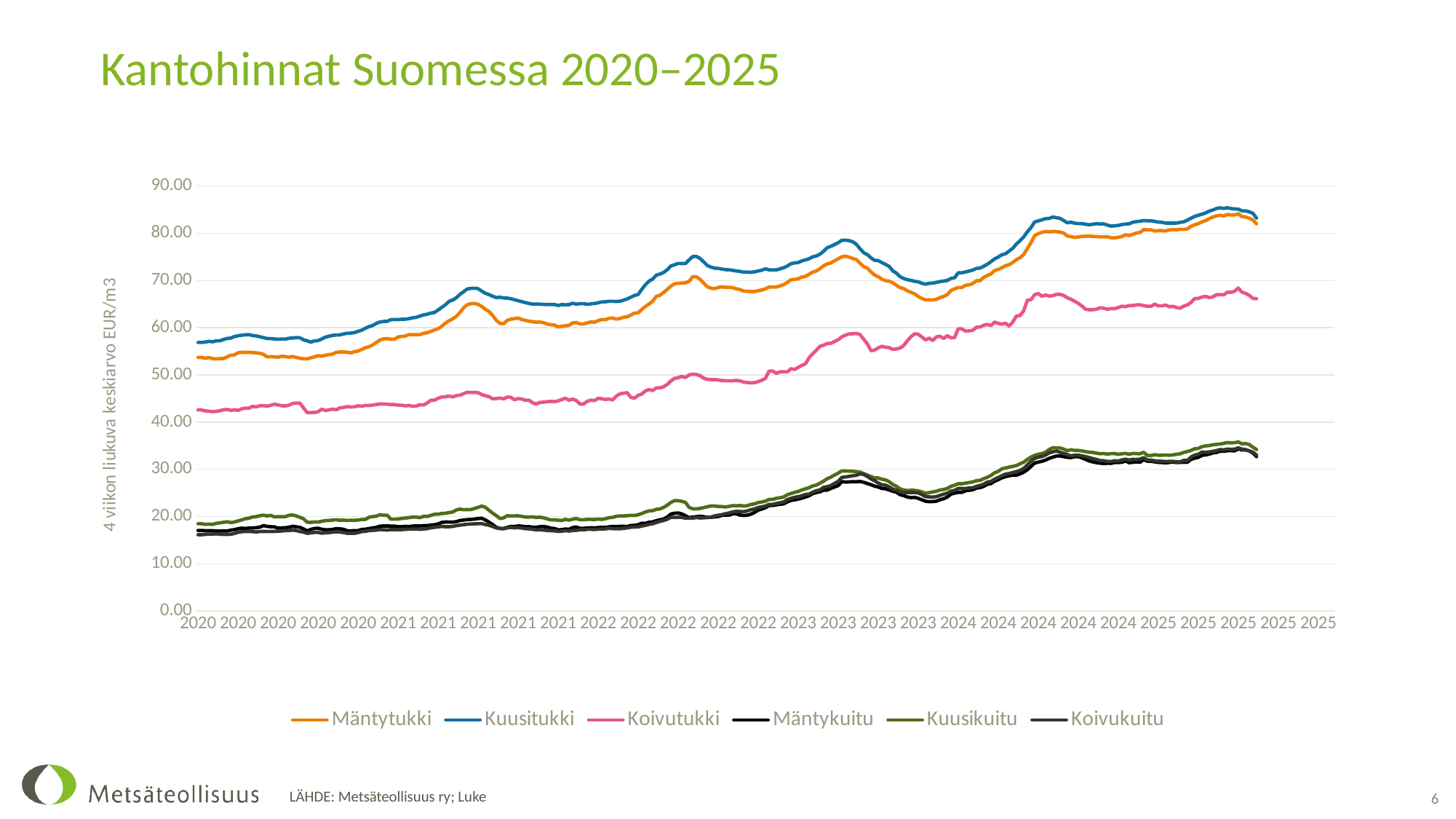
What is the title of the chart? Kantohinnat Suomessa 2020–2025 Does the Koivutukki series generally rise or fall from 2020 to 2025? rise Is the value for Kuusikuitu at the end of 2025 greater or less than 40? less How many series does the legend list? 6 Does the Kuusitukki series generally rise or fall from 2020 to 2025? rise Of the three 'tukki' series (Mäntytukki, Kuusitukki, Koivutukki), which has the lowest values? Koivutukki At the end of 2025, which is larger: Koivutukki or Kuusikuitu? Koivutukki What is the label on the vertical axis? 4 viikon liukuva keskiarvo EUR/m3 What kind of chart is shown on the slide? line chart Is the peak value for Kuusitukki in 2025 greater or less than 80? greater Is the value for Koivutukki at the start of 2020 greater or less than 50? less Which series has the highest values across the whole period? Kuusitukki